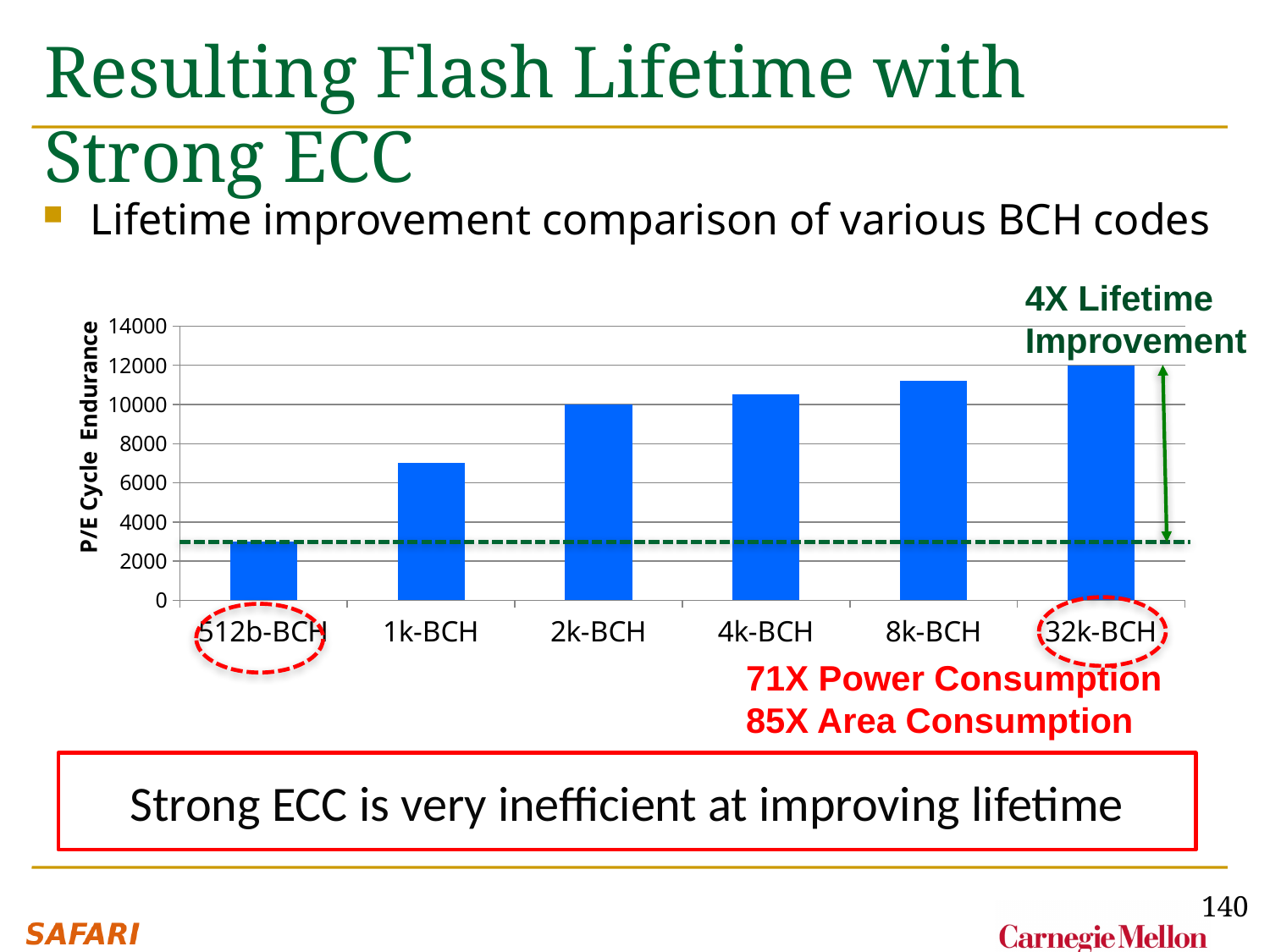
Do the P/E cycle endurance values rise or fall from 512b-BCH to 32k-BCH? rise What lifetime improvement does the green annotation next to the 32k-BCH bar state? 4X Lifetime Improvement How many BCH code categories are plotted on the x axis? 6 Is the value for 4k-BCH greater or less than 12000? less Is the value for 1k-BCH greater or less than 6000? greater What kind of chart is shown on the slide? bar chart Which BCH code has the highest P/E cycle endurance? 32k-BCH What is the label of the y axis? P/E Cycle Endurance Which BCH code has the lowest P/E cycle endurance? 512b-BCH Is the value for 512b-BCH greater or less than 4000? less Which has a higher P/E cycle endurance, 1k-BCH or 2k-BCH? 2k-BCH